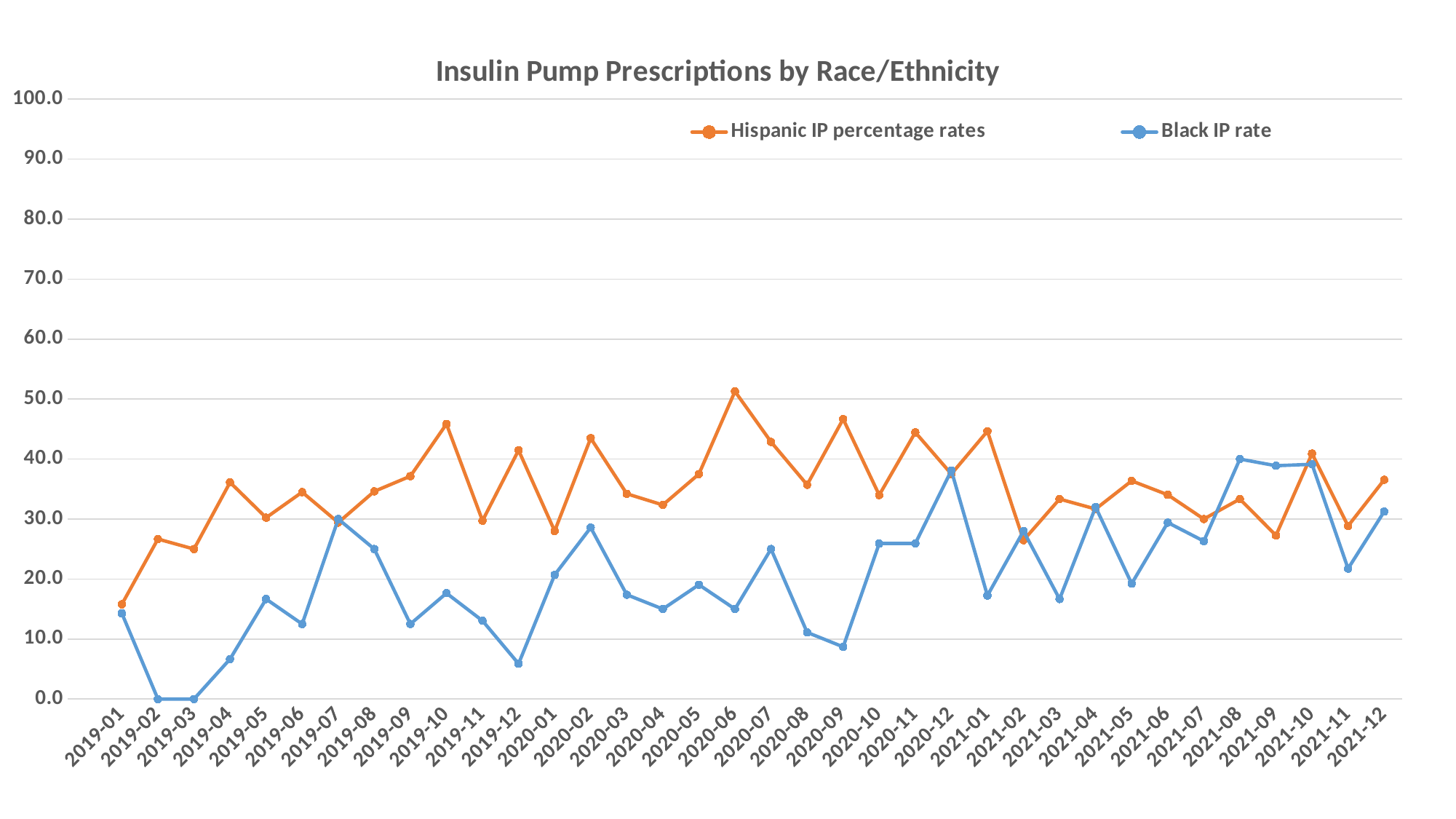
What is the title of the chart? Insulin Pump Prescriptions by Race/Ethnicity What is the lowest value of the Black IP rate series? 0.0 Which series has the larger value in 2020-06, Hispanic IP percentage rates or Black IP rate? Hispanic IP percentage rates Which series has the larger value in 2021-08, Hispanic IP percentage rates or Black IP rate? Black IP rate What is the Black IP rate in 2019-02? 0.0 Is the Hispanic IP percentage rate in 2020-06 greater or less than 40? greater In which month does the Hispanic IP percentage rate reach its highest value? 2020-06 Which series is drawn in orange? Hispanic IP percentage rates How many series does the legend list? 2 Is the Black IP rate in 2019-12 greater or less than 10? less What kind of chart is shown on the slide? Line chart How many monthly points are plotted along the x axis? 36